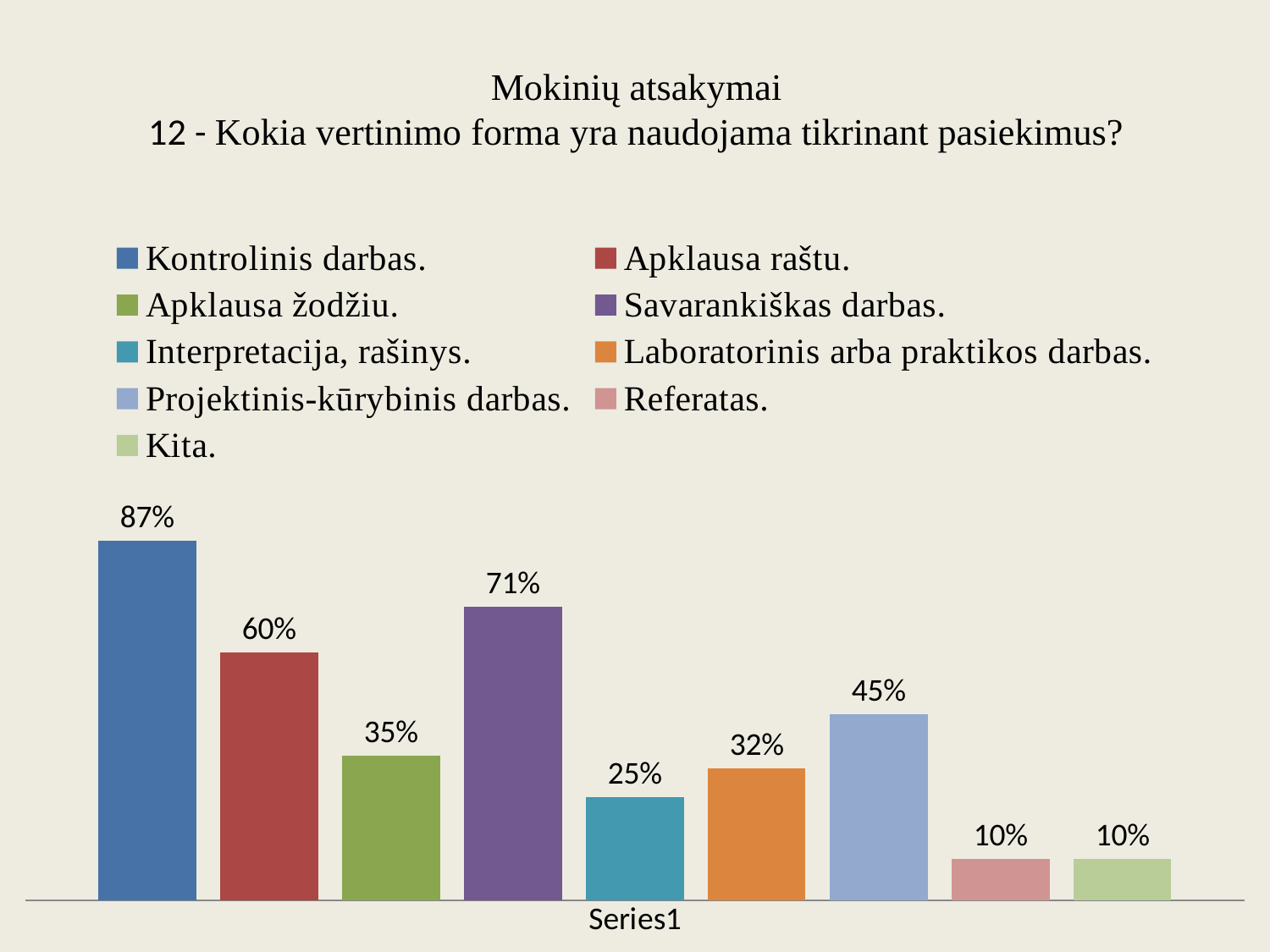
Which is larger, the value for Apklausa žodžiu or the value for Projektinis-kūrybinis darbas? Projektinis-kūrybinis darbas. What is the value for Kontrolinis darbas? 87% What is the value for Projektinis-kūrybinis darbas? 45% What kind of chart is shown on the slide? bar chart What is the difference between the values for Kontrolinis darbas and Apklausa raštu? 27% How many bars are plotted in the chart? 9 What is the value for Savarankiškas darbas? 71% What is the difference between the values for Savarankiškas darbas and Interpretacija, rašinys? 46% How many entries does the legend list? 9 Which category has the highest value? Kontrolinis darbas. What is the value for Laboratorinis arba praktikos darbas? 32% What value is shown for both Referatas and Kita? 10%